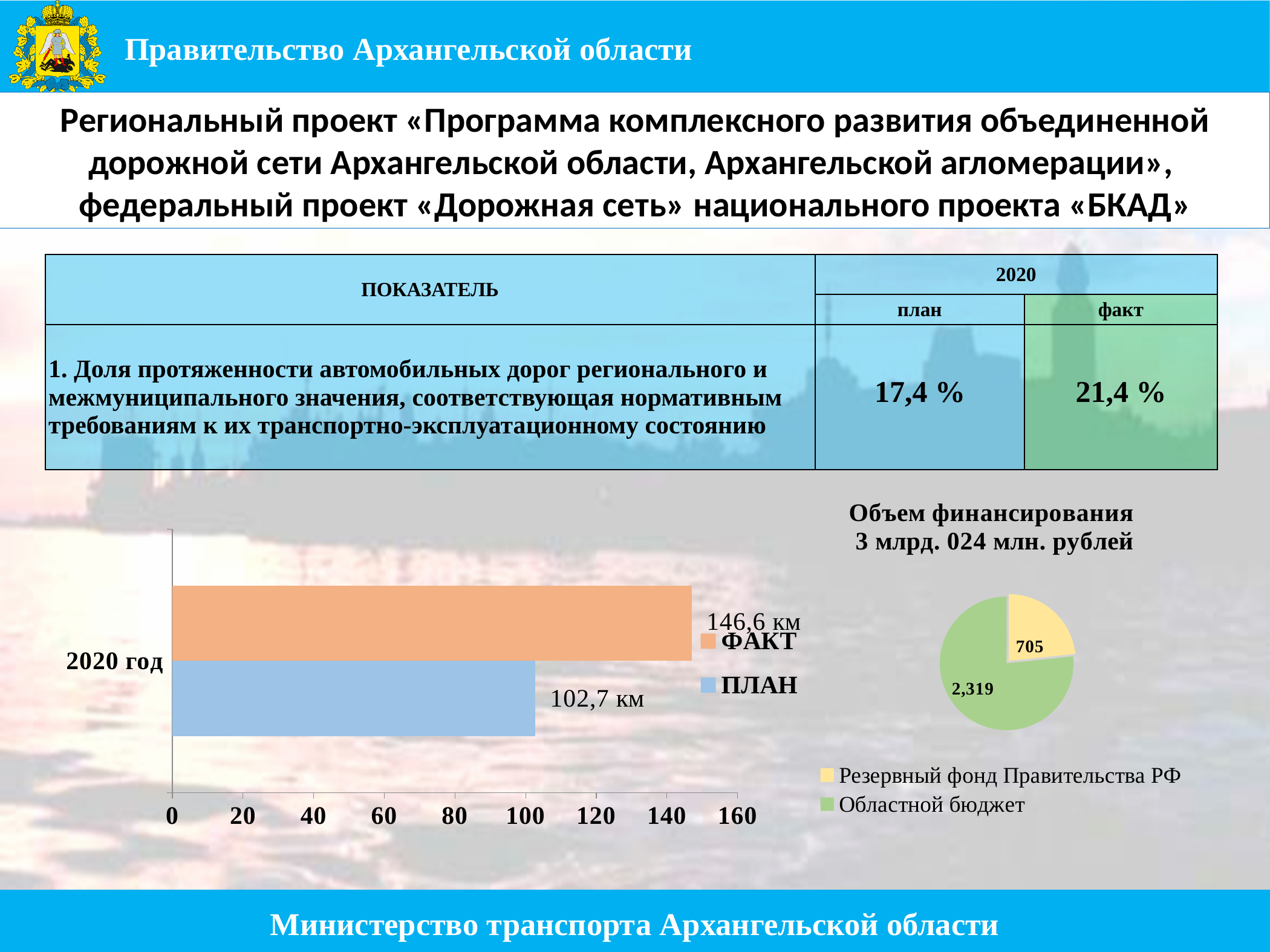
In the pie chart titled 'Объем финансирования', how many slices are there? 2 In the pie chart titled 'Объем финансирования', what is the value for Областной бюджет? 2,319 In the pie chart titled 'Объем финансирования', what colour is the Областной бюджет slice? Green In the pie chart titled 'Объем финансирования', what is the value for Резервный фонд Правительства РФ? 705 In the bar chart on the left, what is the value for ФАКТ in 2020 год? 146,6 км In the bar chart on the left, how many series does the legend list? 2 In the bar chart on the left, is the value for ПЛАН greater or less than 120? less What kind of chart is the chart on the left showing 2020 год? Bar chart In the bar chart on the left, which series has the larger value for 2020 год, ФАКТ or ПЛАН? ФАКТ In the bar chart on the left, what is the value for ПЛАН in 2020 год? 102,7 км In the pie chart titled 'Объем финансирования', which slice is the largest? Областной бюджет In the bar chart on the left, by how much does ФАКТ exceed ПЛАН for 2020 год? 43,9 км